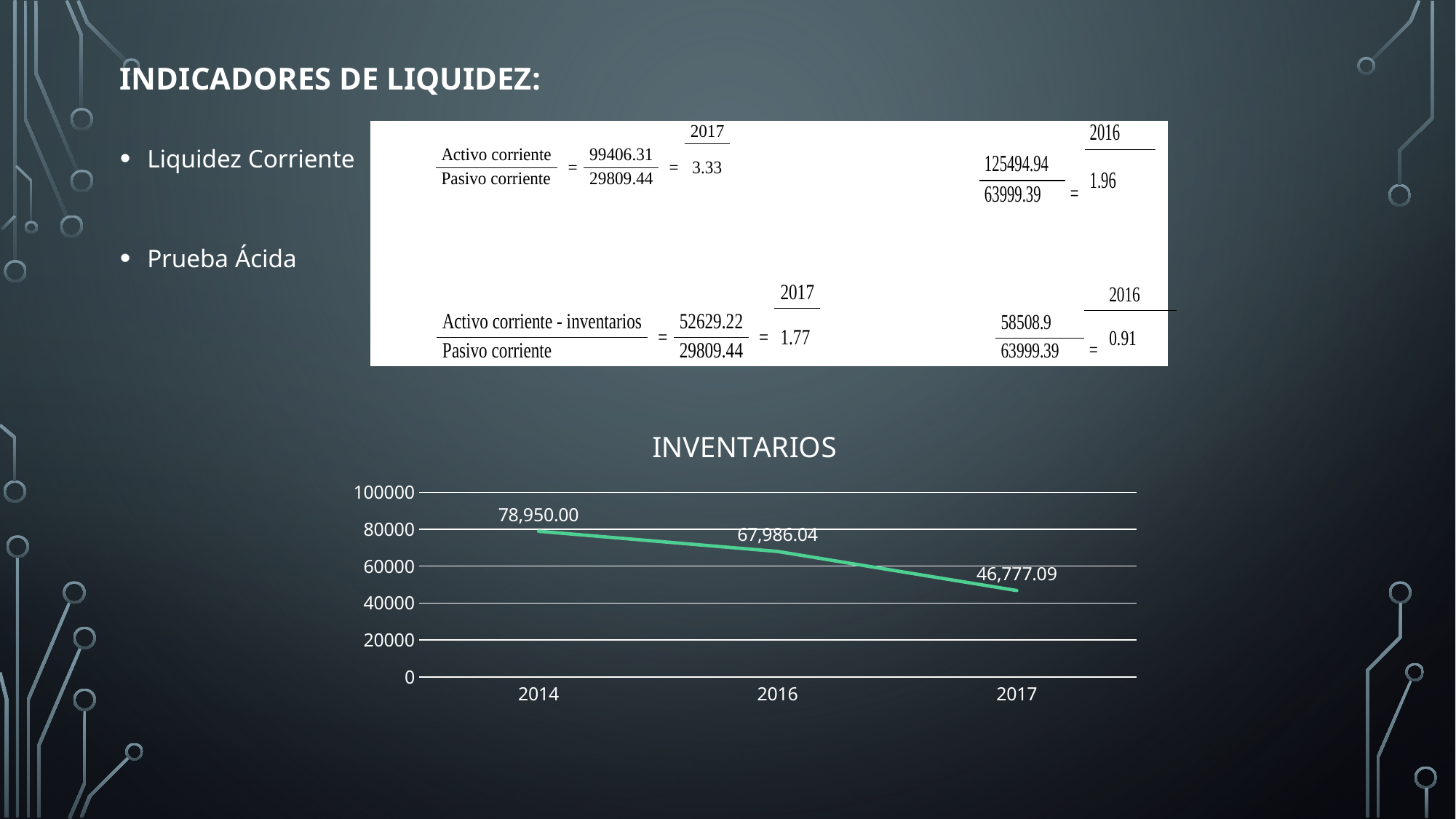
What is the inventory value shown for 2017 in the INVENTARIOS chart? 46,777.09 What is the inventory value shown for 2016 in the INVENTARIOS chart? 67,986.04 How many years are plotted in the INVENTARIOS chart? 3 In the INVENTARIOS chart, is the inventory value higher in 2016 or in 2017? 2016 What is the difference between the 2016 and 2017 inventory values in the INVENTARIOS chart? 21,208.95 What type of chart is the INVENTARIOS chart? line chart Which year has the highest inventory value in the INVENTARIOS chart? 2014 Which year has the lowest inventory value in the INVENTARIOS chart? 2017 Is the 2017 inventory value in the INVENTARIOS chart greater or less than 60000? less What is the inventory value shown for 2014 in the INVENTARIOS chart? 78,950.00 By how much did the inventory value fall from 2014 to 2016 in the INVENTARIOS chart? 10,963.96 Do the inventory values rise or fall from 2014 to 2017 in the INVENTARIOS chart? fall